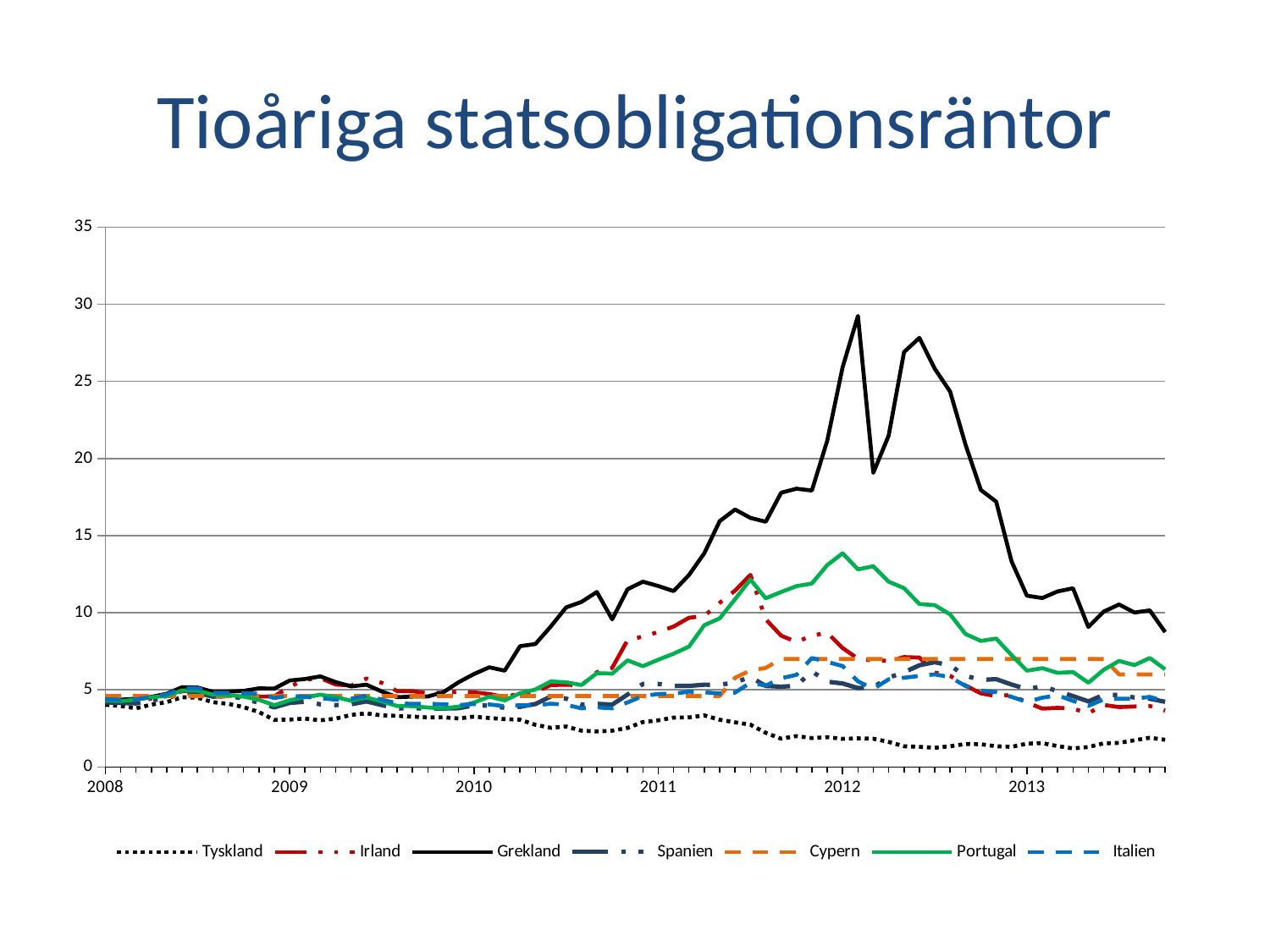
How many series does the legend list? 7 Is the peak value for Portugal greater or less than 15? less What kind of chart is shown on the slide? line chart Which series has the lowest value at the end of 2013? Tyskland At the start of 2012, which is larger, the value for Grekland or the value for Portugal? Grekland Which series is drawn as a solid green line? Portugal Is the value for Tyskland at the end of 2013 greater or less than 5? less Which series reaches the highest value on the chart? Grekland Does the value for Grekland rise or fall from 2008 to early 2012? rise What is the title of the chart? Tioåriga statsobligationsräntor Does the value for Tyskland rise or fall from 2008 to 2013? fall Is the peak value for Grekland greater or less than 25? greater